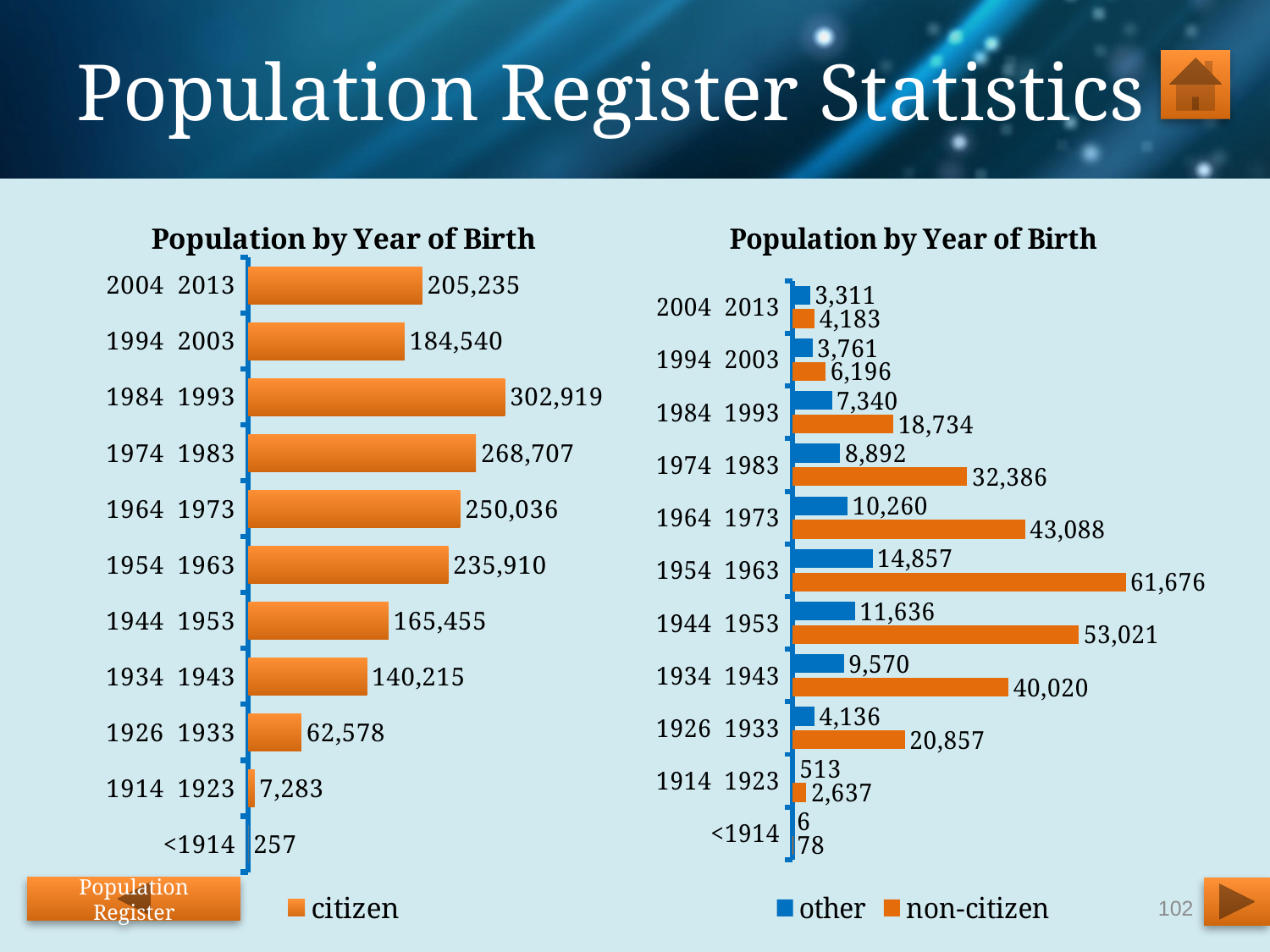
In the right chart (other and non-citizen), what is the difference between the non-citizen and other values for the 1944–1953 group? 41,385 What type of chart is the left chart (citizen)? bar chart In the right chart (other and non-citizen), what is the non-citizen value for the 1954–1963 group? 61,676 How many series does the legend of the right chart list? 2 In the left chart (citizen), how many birth-year groups are shown? 11 In the right chart (other and non-citizen), which birth-year group has the highest 'other' value? 1954 1963 In the left chart (citizen), what is the difference between the values for 2004–2013 and 1994–2003? 20,695 In the left chart (citizen), what is the value for the 1984–1993 birth-year group? 302,919 In the left chart (citizen), which birth-year group has the highest value? 1984 1993 In the right chart (other and non-citizen), what is the 'other' value for the 1964–1973 group? 10,260 In the left chart (citizen), which birth-year group has the lowest value? <1914 In the right chart (other and non-citizen), which is larger for the 1934–1943 group: other or non-citizen? non-citizen